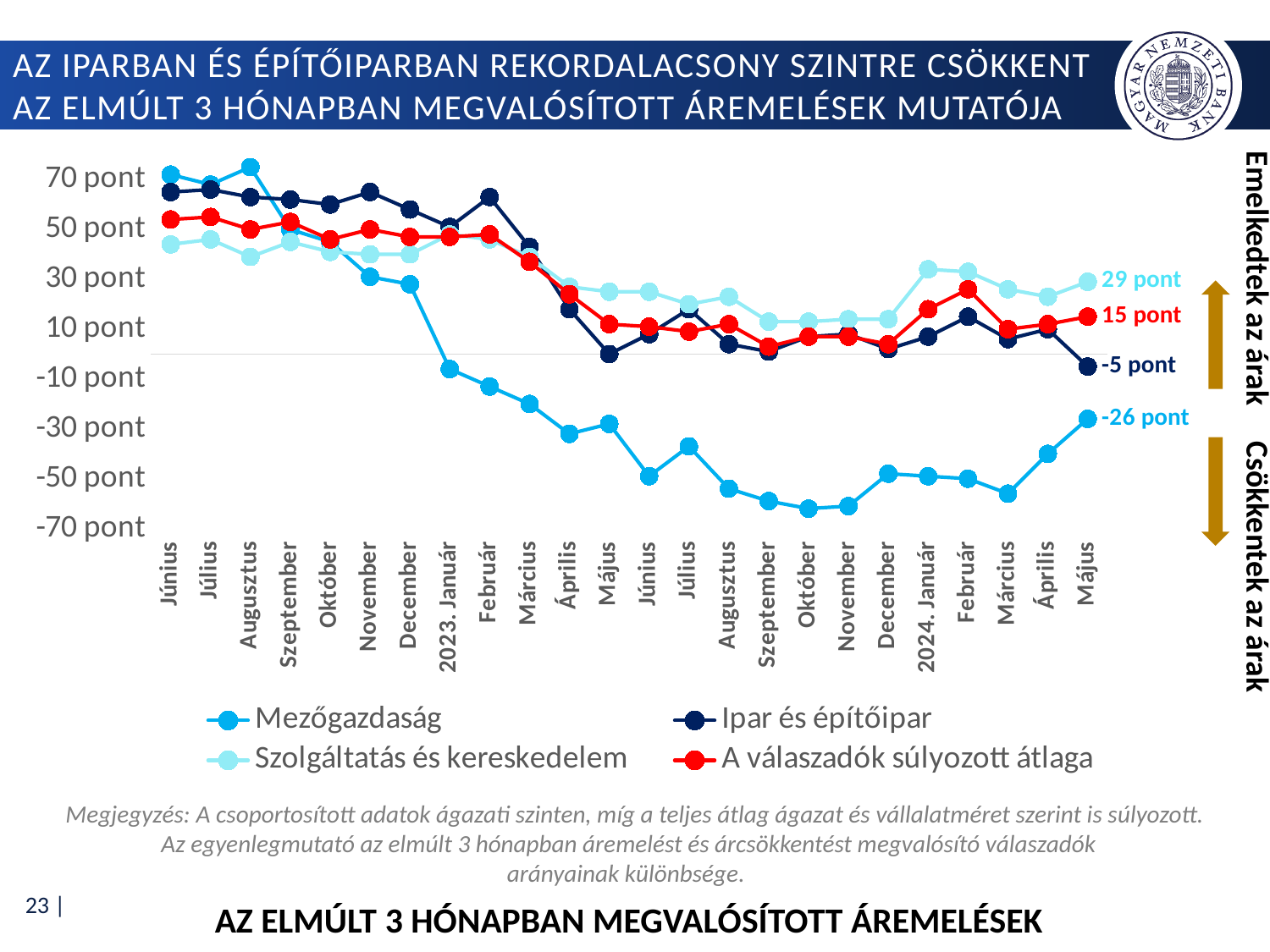
What is the value for Ipar és építőipar in Május 2024? -5 pont What is the value for Szolgáltatás és kereskedelem in Május 2024? 29 pont Is the value for Mezőgazdaság in Október 2023 greater or less than -50 pont? less What is the difference between Szolgáltatás és kereskedelem and A válaszadók súlyozott átlaga in Május 2024? 14 pont Does the Mezőgazdaság series rise or fall from Június 2022 to Május 2024? fall What is the difference between A válaszadók súlyozott átlaga and Ipar és építőipar in Május 2024? 20 pont How many series does the legend list? 4 What kind of chart is shown on the slide? line chart Which series has the highest value in Május 2024? Szolgáltatás és kereskedelem What is the value for Mezőgazdaság in Május 2024? -26 pont What is the value for A válaszadók súlyozott átlaga in Május 2024? 15 pont Which series has the lowest value in Május 2024? Mezőgazdaság